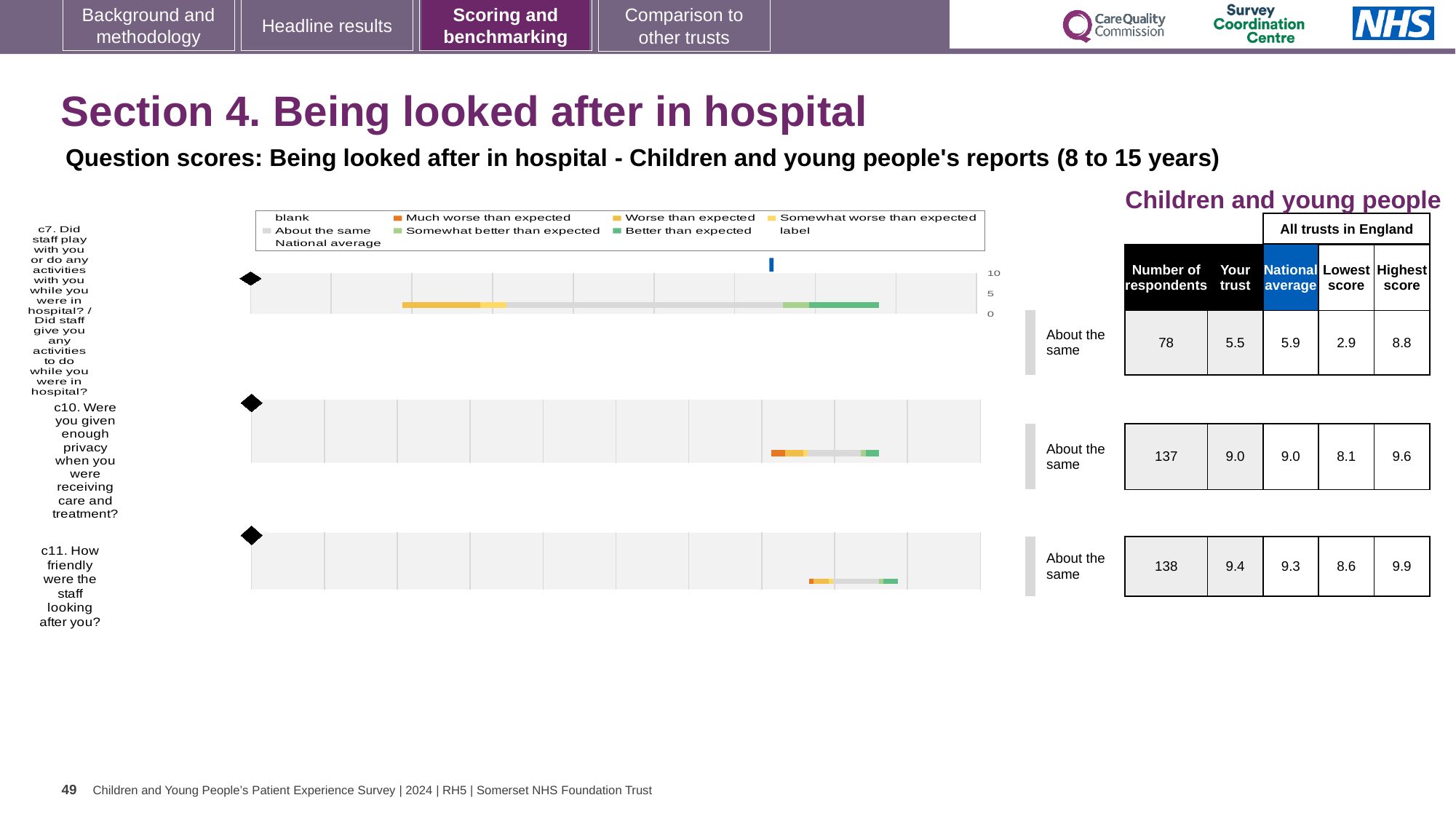
By how much is the 'Your trust' score for c7 below the national average? 0.4 For c11, which is larger: the 'Your trust' score or the national average? Your trust What kind of chart is used to show the question scores on this slide? bar chart What is the highest score across all trusts in England for c7? 8.8 What is the difference between the highest score and the lowest score for c10? 1.5 Which question has the highest 'Your trust' score? c11 How many respondents answered c7 (Did staff play with you or do any activities with you while you were in hospital?)? 78 What is the national average score for c11 (How friendly were the staff looking after you?)? 9.3 Which question has the lowest number of respondents? c7 What benchmark category is shown for c10? About the same What is the 'Your trust' score for c10 (Were you given enough privacy when you were receiving care and treatment?)? 9.0 How many survey questions are plotted on the slide? 3